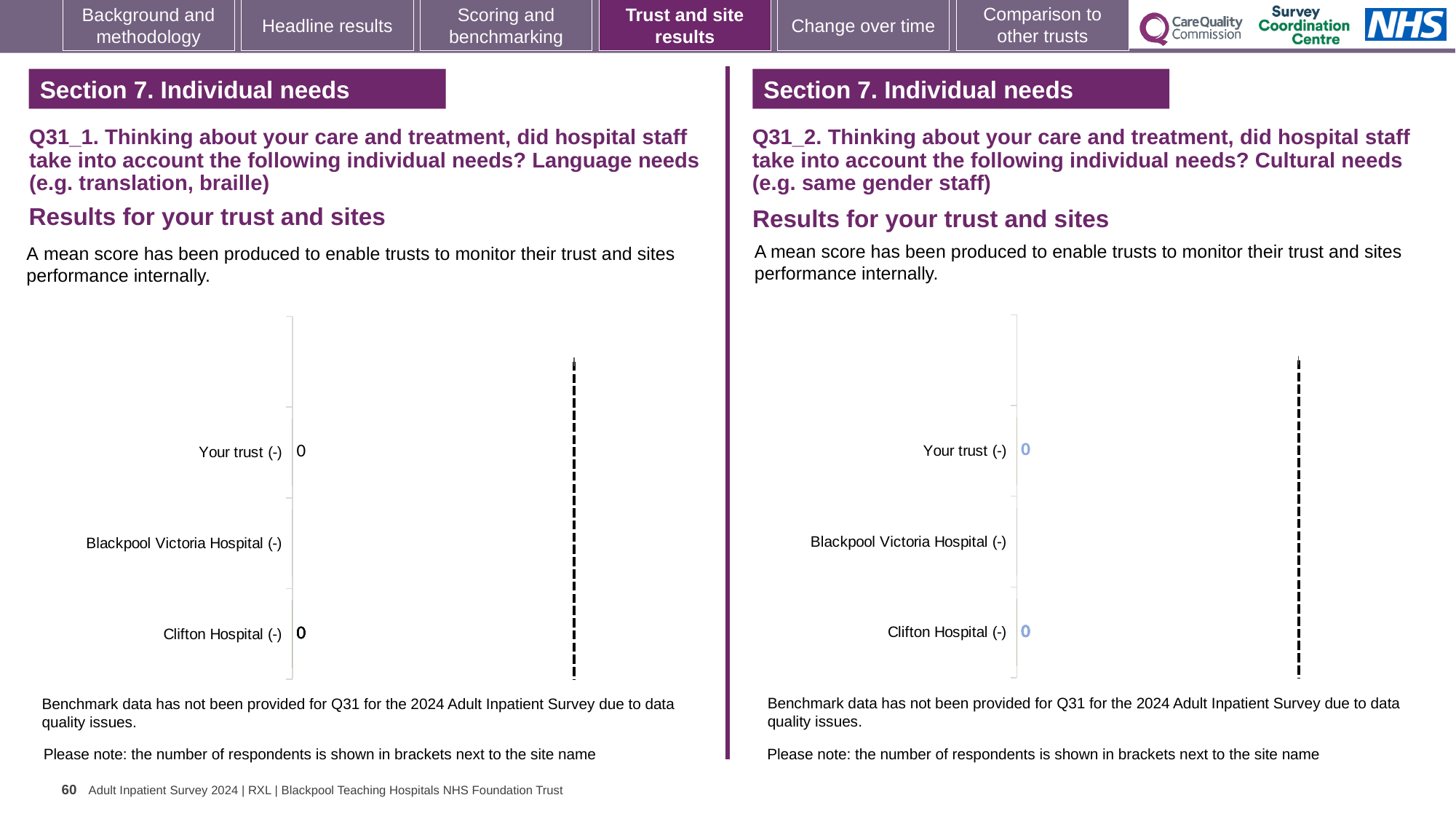
On the right chart (Q31_2, Cultural needs), what value is shown for Clifton Hospital (-)? 0 On the right chart (Q31_2, Cultural needs), what value is shown for Your trust (-)? 0 How many categories are listed on the right chart (Q31_2, Cultural needs)? 3 How many categories are listed on the left chart (Q31_1, Language needs)? 3 On the left chart (Q31_1, Language needs), what value is shown for Your trust (-)? 0 On the left chart (Q31_1, Language needs), which category is listed between Your trust (-) and Clifton Hospital (-)? Blackpool Victoria Hospital (-) On the right chart (Q31_2, Cultural needs), which category has no data label shown? Blackpool Victoria Hospital (-) On the left chart (Q31_1, Language needs), what value is shown for Clifton Hospital (-)? 0